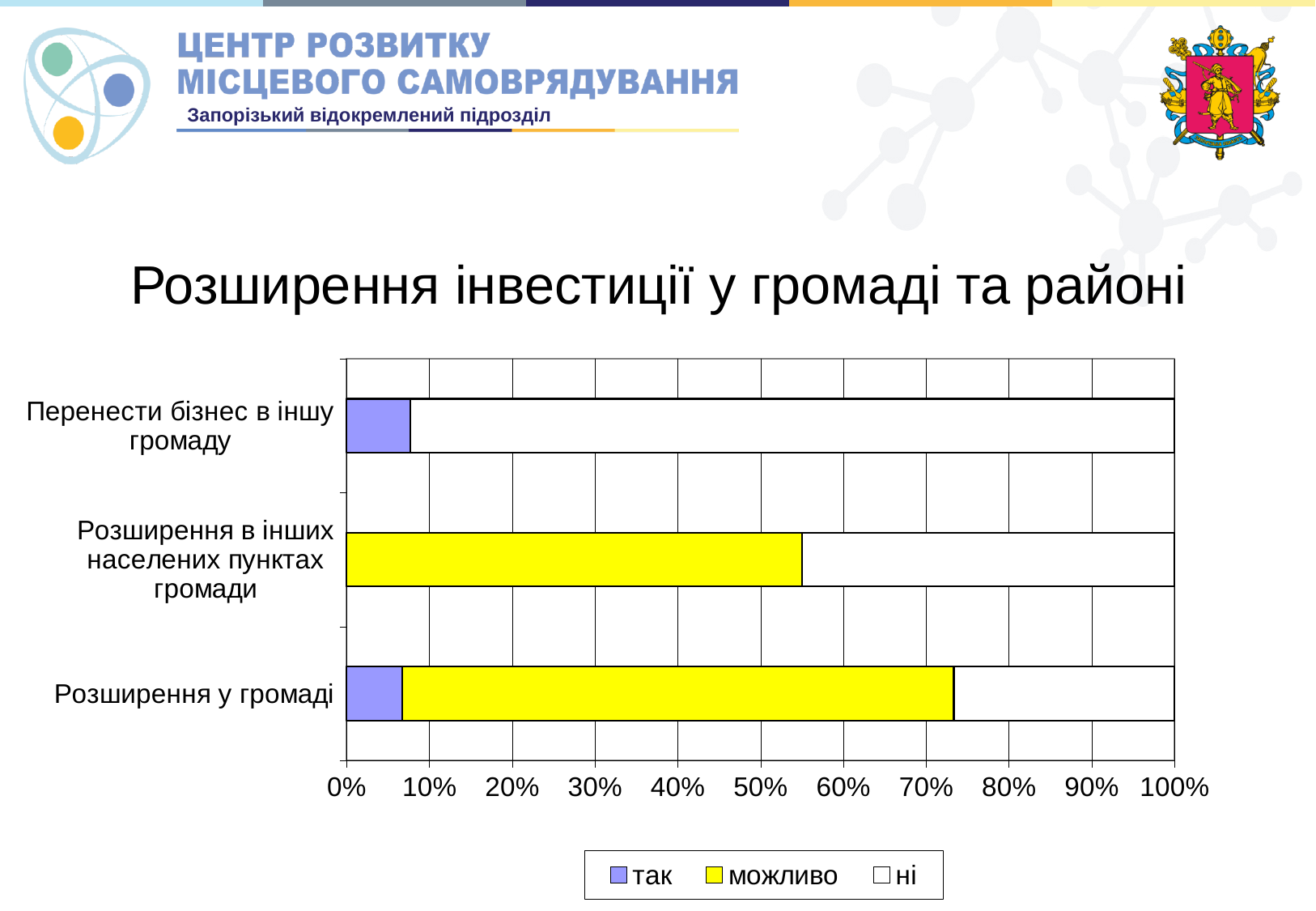
What is the title of the chart on the slide? Розширення інвестиції у громаді та районі Which colour represents the series "можливо" in the legend? yellow Is the "так" share for "Перенести бізнес в іншу громаду" greater or less than 10%? less What kind of chart is shown on the slide? stacked bar chart Is the "можливо" share for "Розширення у громаді" greater or less than 60%? greater Which category has the largest "ні" share? Перенести бізнес в іншу громаду Which has a larger "можливо" share: "Розширення у громаді" or "Розширення в інших населених пунктах громади"? Розширення у громаді Which category has the largest "можливо" share? Розширення у громаді Is the "ні" share for "Розширення у громаді" greater or less than 30%? less How many series does the legend list? 3 How many categories are shown on the chart? 3